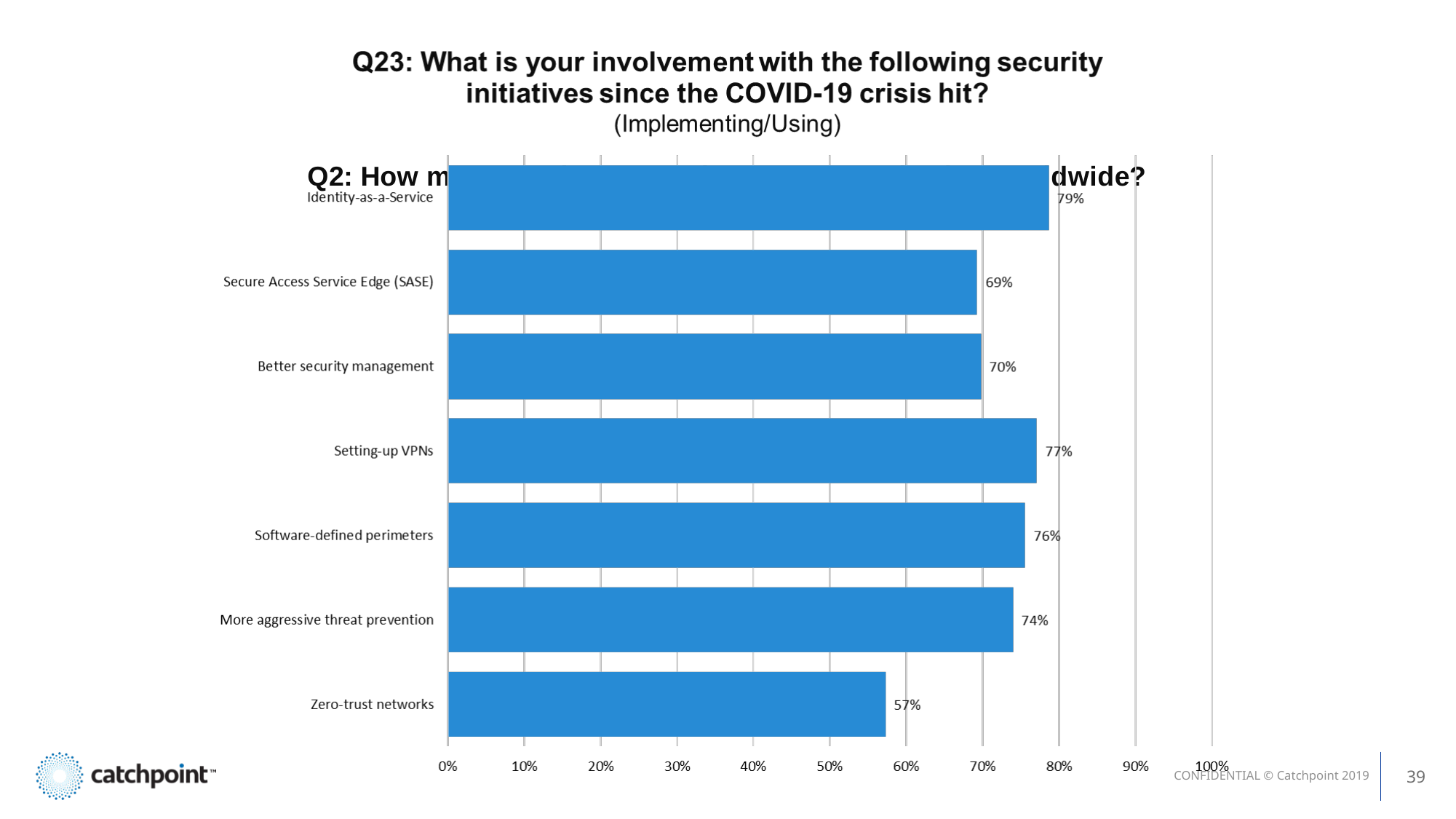
What is the value for Setting-up VPNs? 77% How many security initiatives are shown in the chart? 7 What is the value for Identity-as-a-Service? 79% What is the value for More aggressive threat prevention? 74% What kind of chart is shown on the slide? Bar chart What is the value for Secure Access Service Edge (SASE)? 69% Which security initiative has the lowest value? Zero-trust networks What is the difference between the values for Setting-up VPNs and More aggressive threat prevention? 3% Which is larger, the value for Software-defined perimeters or the value for Better security management? Software-defined perimeters What is the value for Zero-trust networks? 57% Which security initiative has the highest value? Identity-as-a-Service What is the difference between the values for Identity-as-a-Service and Zero-trust networks? 22%